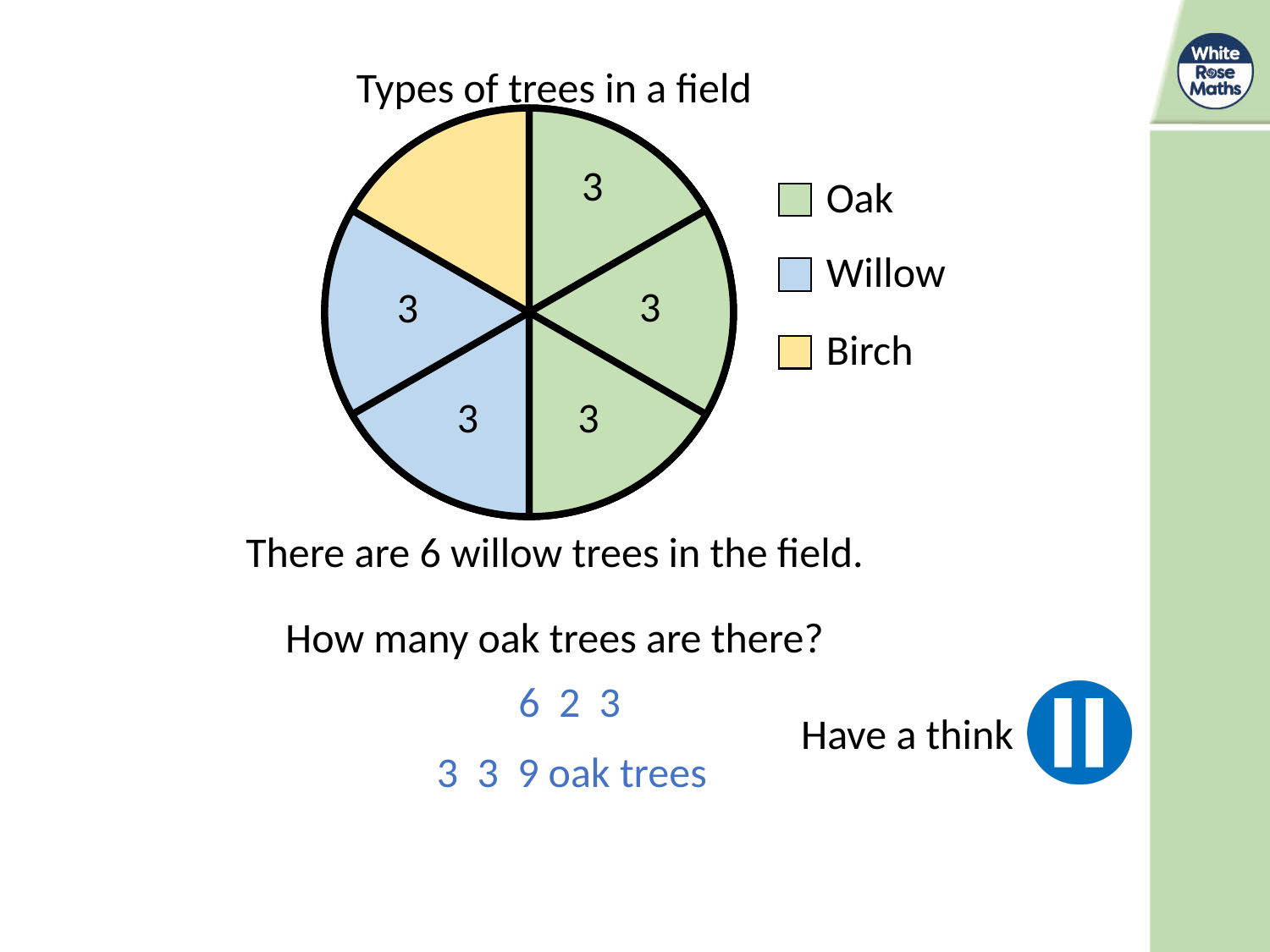
What fraction of the pie chart does Birch take up? 1/6 How many sectors is the pie chart divided into? 6 How many sectors of the pie chart are coloured for Oak? 3 Which type of tree has the most sectors in the pie chart? Oak What is the title of the pie chart? Types of trees in a field What kind of chart is shown on the slide? pie chart How many sectors of the pie chart are coloured for Willow? 2 How many entries does the legend of the pie chart list? 3 Which type of tree has the fewest sectors in the pie chart? Birch Which takes up a larger part of the pie chart, Oak or Willow? Oak What fraction of the pie chart does Oak take up? 1/2